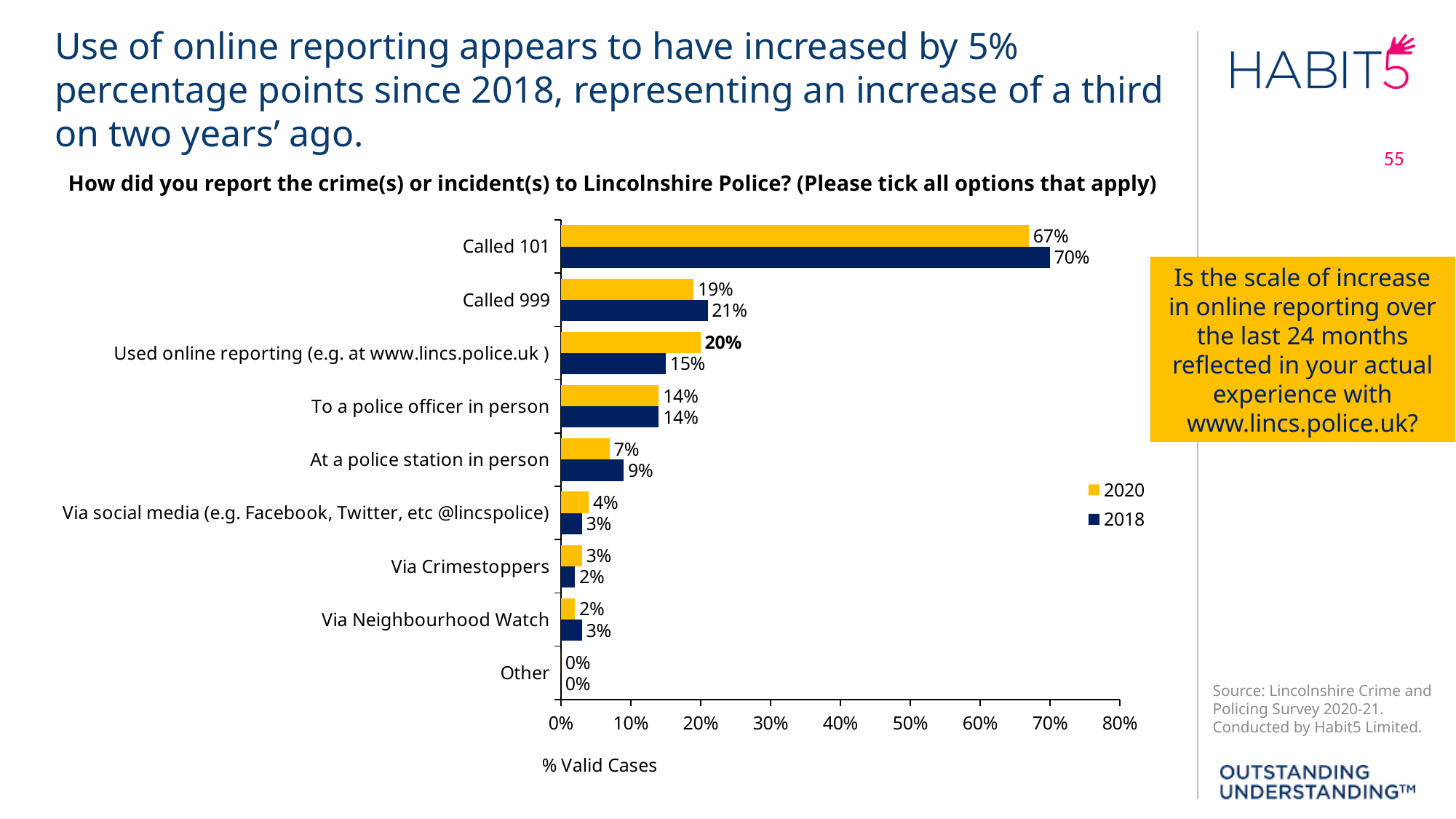
How many categories are shown on the chart? 9 Which category has the highest 2018 value? Called 101 What is the difference between the 2020 and 2018 values for Used online reporting? 5% Is the 2018 value for Called 101 greater or less than 60%? greater What is the 2020 value for Called 101? 67% Which is larger for Called 999: the 2020 value or the 2018 value? 2018 Which category has the lowest 2020 value? Other How many series does the legend list? 2 What is the 2018 value for Used online reporting (e.g. at www.lincs.police.uk)? 15% What kind of chart is shown on the slide? Bar chart What is the label on the horizontal axis of the chart? % Valid Cases What is the 2020 value for At a police station in person? 7%